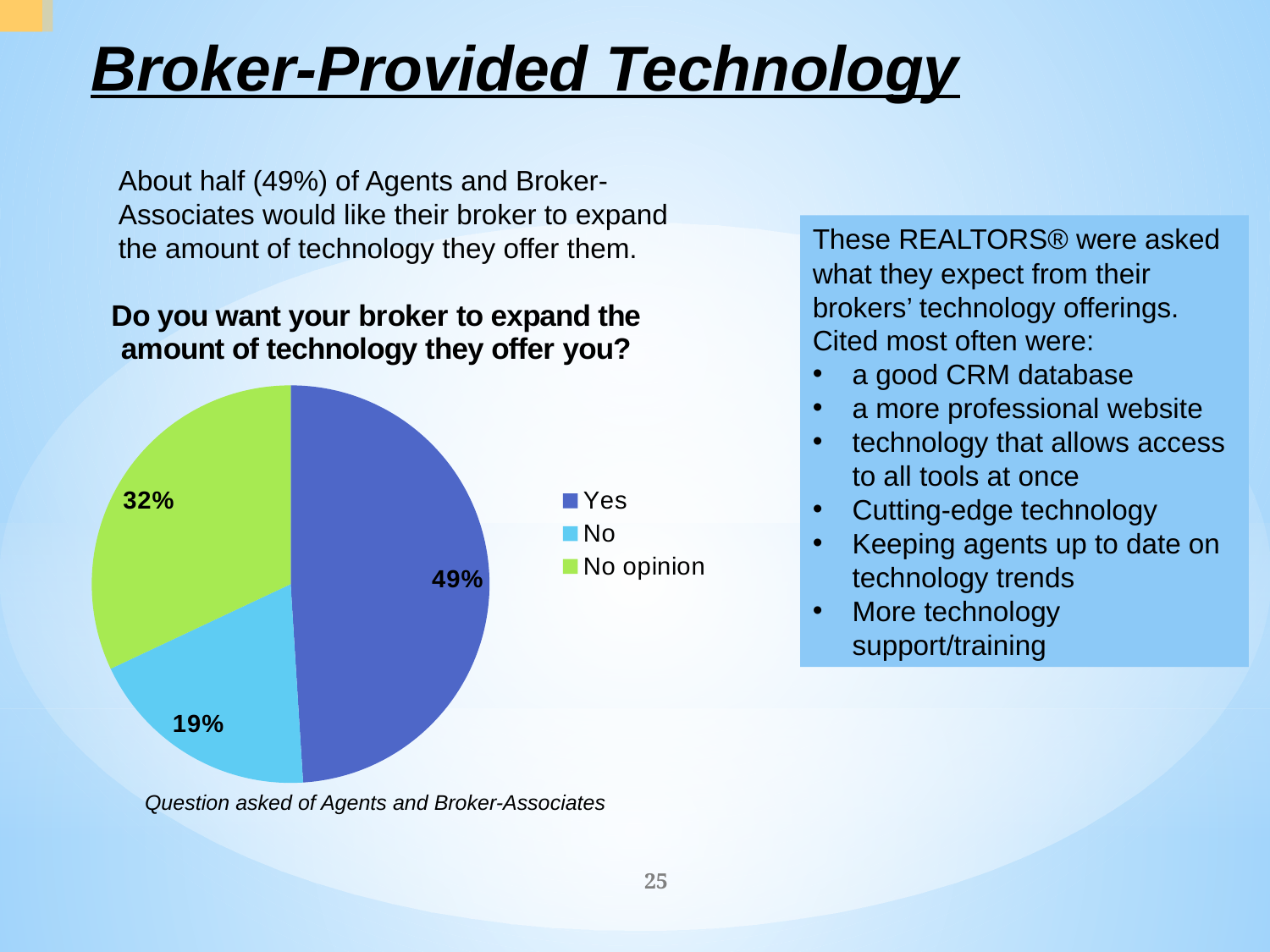
What is the title of the chart? Do you want your broker to expand the amount of technology they offer you? What is the difference in percentage points between the "Yes" and "No" responses? 30 Which is larger, the share for "No opinion" or the share for "No"? No opinion Which response has the smallest share of the pie? No What is the difference in percentage points between "No opinion" and "No"? 13 What percentage of respondents answered "Yes" to wanting their broker to expand the amount of technology they offer? 49% How many categories does the pie chart show? 3 Which response has the largest share of the pie? Yes Which colour represents the "No opinion" slice in the pie chart? Green What percentage of respondents answered "No"? 19% What type of chart is shown on the slide? Pie chart What percentage of respondents had "No opinion"? 32%